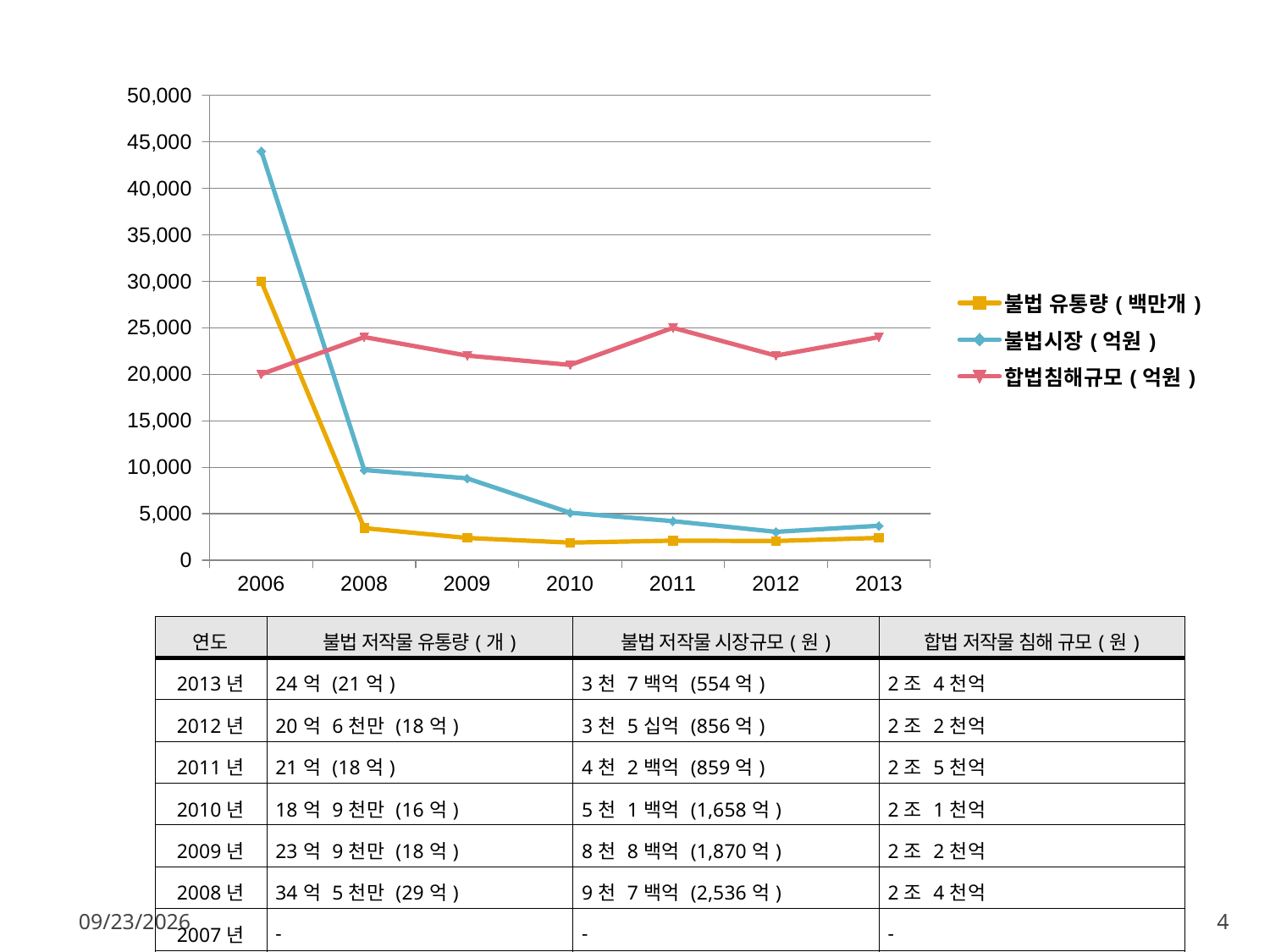
How many years are shown along the x axis of the chart? 7 In 2006, which series has the larger value: 불법시장 ( 억원 ) or 불법 유통량 ( 백만개 )? 불법시장 ( 억원 ) How many series does the chart legend list? 3 Is the value for 불법 유통량 ( 백만개 ) in 2006 greater or less than 25,000? greater Is the value for 불법시장 ( 억원 ) in 2010 greater or less than 10,000? less In which year is the 합법침해규모 ( 억원 ) series at its lowest? 2006 In which year is the 불법시장 ( 억원 ) series at its highest? 2006 Does the 불법시장 ( 억원 ) series rise or fall from 2006 to 2012? fall In which year is the 합법침해규모 ( 억원 ) series at its highest? 2011 In 2013, which series has the larger value: 합법침해규모 ( 억원 ) or 불법시장 ( 억원 )? 합법침해규모 ( 억원 ) What kind of chart is shown on the slide? line chart Is the value for 불법시장 ( 억원 ) in 2006 greater or less than 40,000? greater